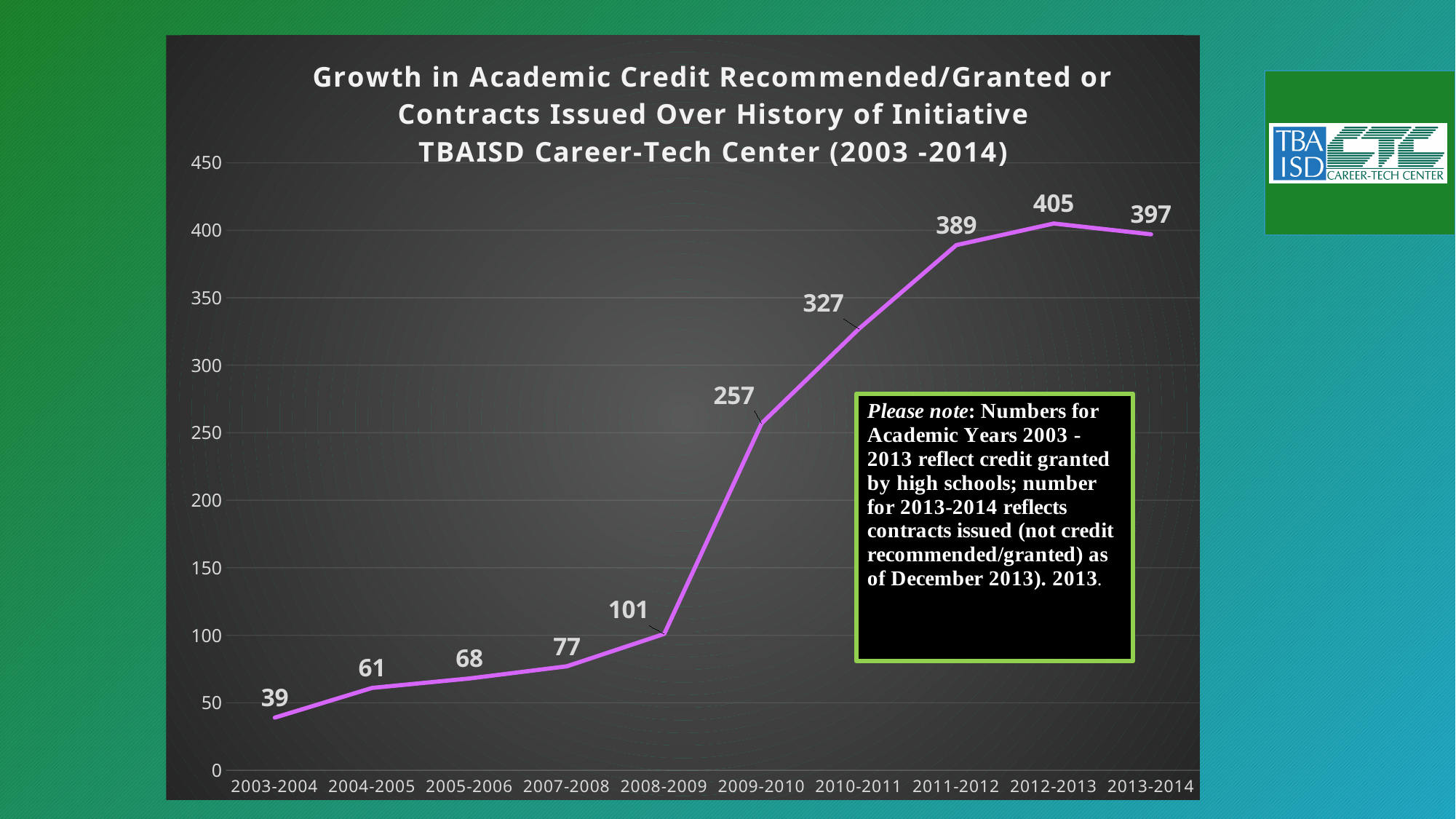
What kind of chart is shown on the slide? line chart Which academic year has the highest value? 2012-2013 What is the difference between the values for 2009-2010 and 2008-2009? 156 What is the value for 2009-2010? 257 Do the values generally rise or fall from 2003-2004 to 2012-2013? rise What is the difference between the values for 2012-2013 and 2013-2014? 8 Which is larger, the value for 2011-2012 or the value for 2010-2011? 2011-2012 Which academic year has the lowest value? 2003-2004 What is the value for 2003-2004? 39 How many academic years are plotted on the x axis? 10 Is the value for 2008-2009 greater or less than 150? less What is the value for 2013-2014? 397